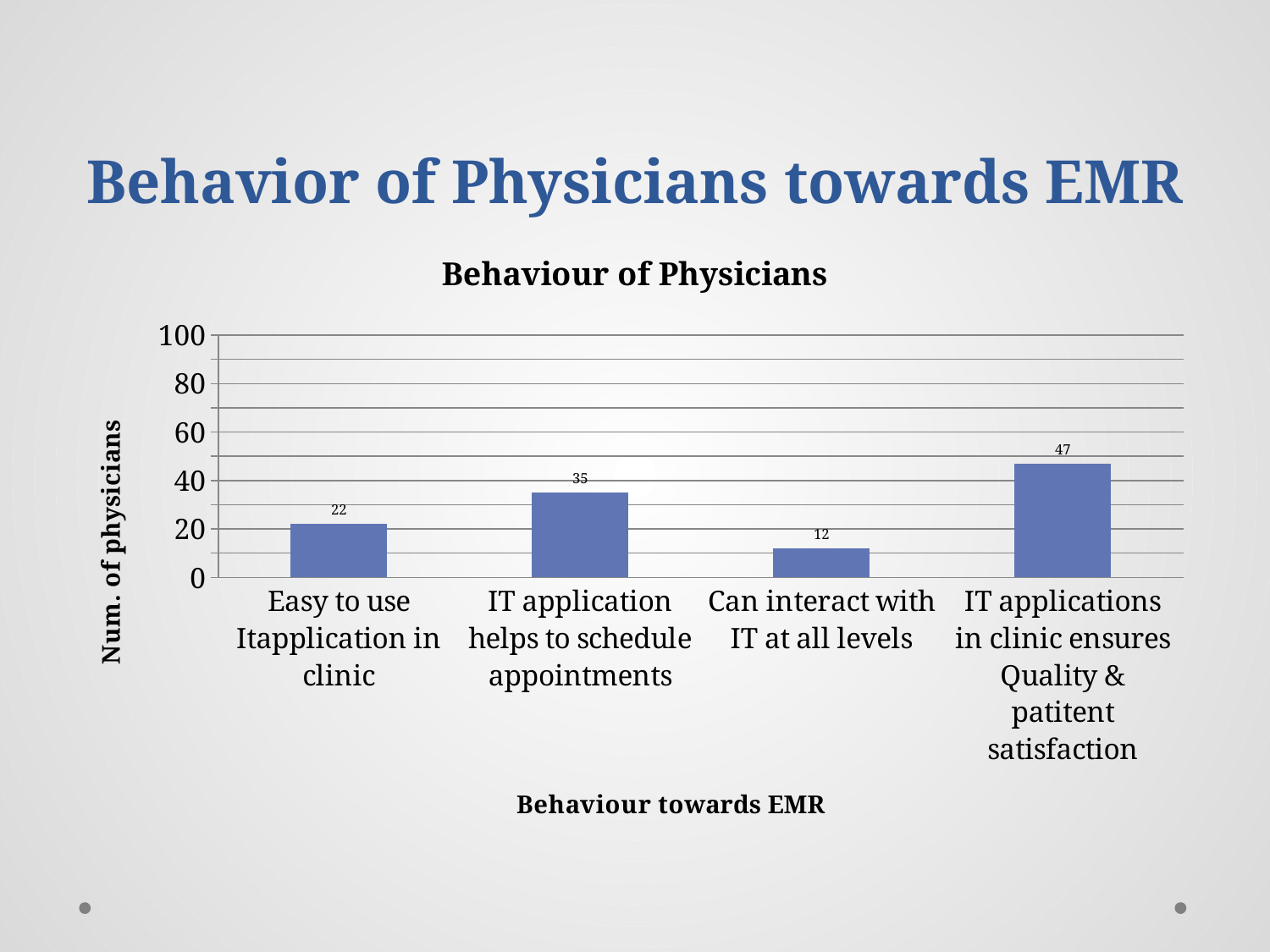
How many categories are shown on the x axis? 4 Which category has the lowest number of physicians? Can interact with IT at all levels What is the title of the chart? Behaviour of Physicians Which is larger: the value for "Easy to use Itapplication in clinic" or "IT application helps to schedule appointments"? IT application helps to schedule appointments What is the number of physicians for "Easy to use Itapplication in clinic"? 22 What kind of chart is shown on the slide? bar chart What is the label of the vertical axis? Num. of physicians What is the difference between the values for "IT applications in clinic ensures Quality & patitent satisfaction" and "Can interact with IT at all levels"? 35 Which category has the highest number of physicians? IT applications in clinic ensures Quality & patitent satisfaction What is the number of physicians for "Can interact with IT at all levels"? 12 Is the value for "IT applications in clinic ensures Quality & patitent satisfaction" greater or less than 40? greater What is the number of physicians for "IT application helps to schedule appointments"? 35